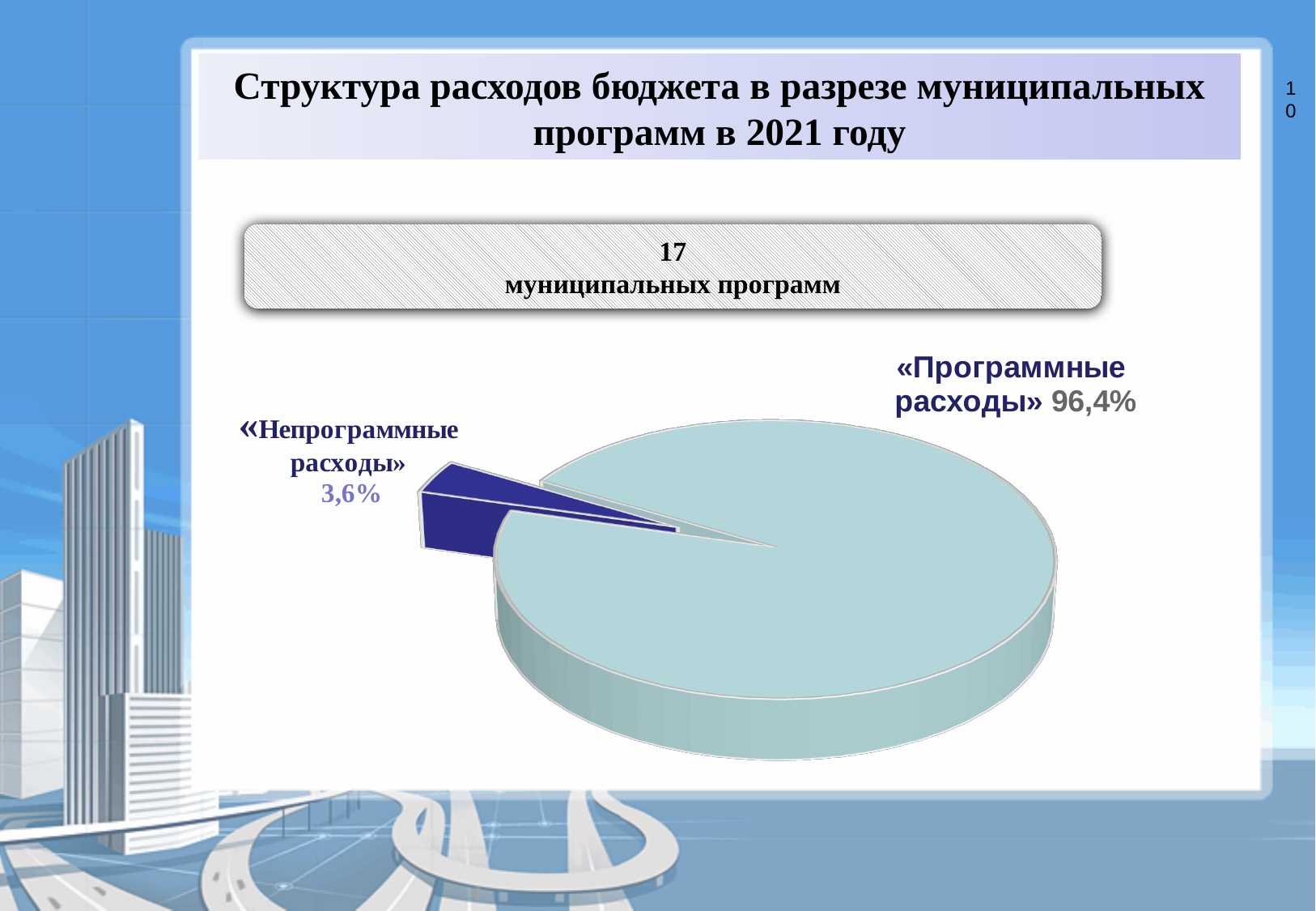
How many slices does the pie chart have? 2 Which is larger: the share of «Программные расходы» or the share of «Непрограммные расходы»? «Программные расходы» What kind of chart is shown on the slide? pie chart Which slice of the pie is the largest? «Программные расходы» What is the difference in percentage points between «Программные расходы» and «Непрограммные расходы»? 92,8 What is the total of the two pie slices? 100% Which slice of the pie is the smallest? «Непрограммные расходы» What is the title of the slide containing the pie chart? Структура расходов бюджета в разрезе муниципальных программ в 2021 году What share of the pie is labelled «Непрограммные расходы»? 3,6% How many municipal programmes are stated in the box above the pie chart? 17 What share of the pie is labelled «Программные расходы»? 96,4%